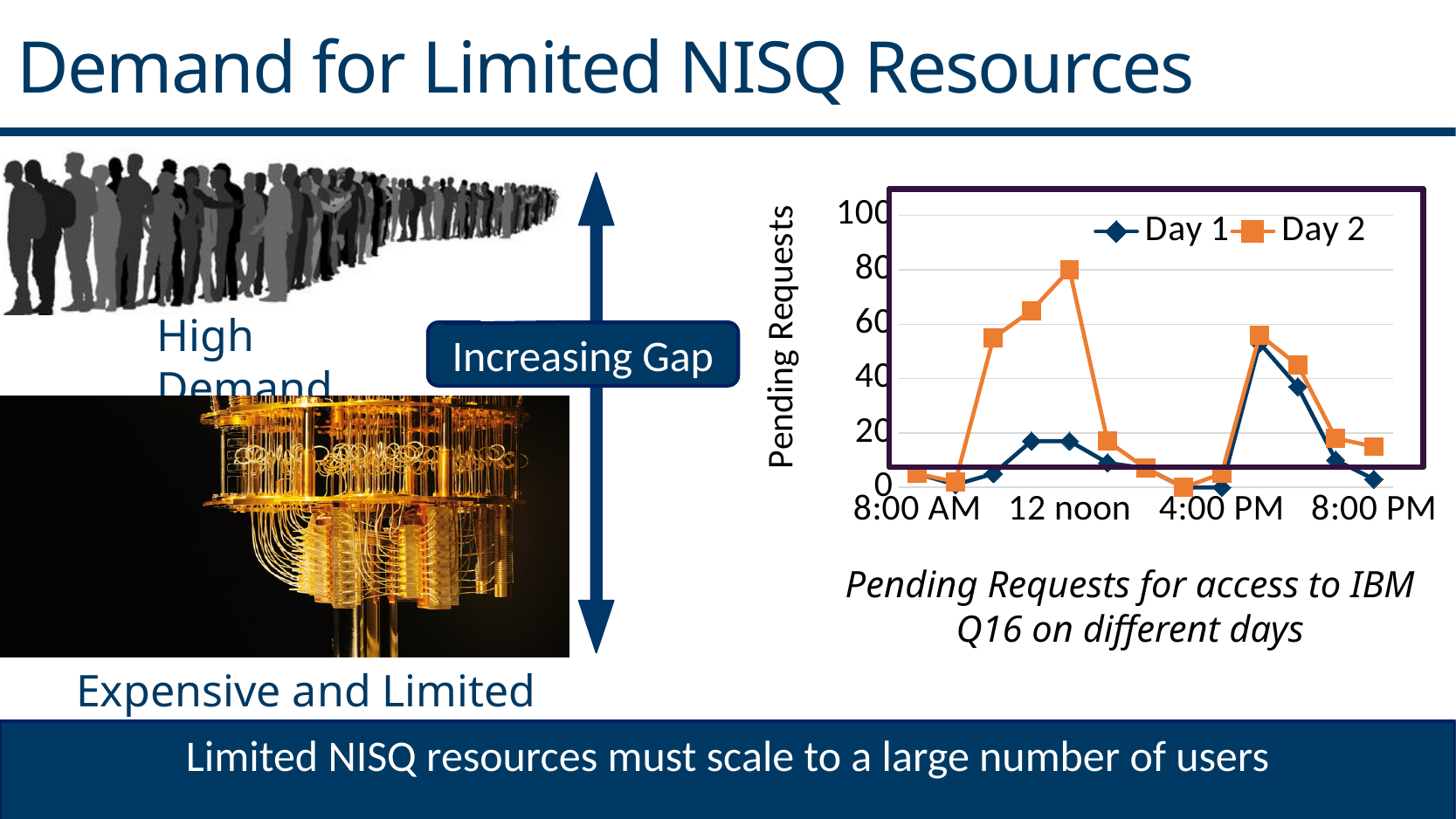
What is the label on the chart's vertical axis? Pending Requests Is the value for Day 1 at 12 noon greater or less than 20? less What kind of chart is shown on the slide? line chart Which series reaches the higher peak value, Day 1 or Day 2? Day 2 Is the value for Day 1 at 8:00 AM greater or less than 20? less How many time labels are shown on the chart's x axis? 4 What are the two series named in the chart's legend? Day 1 and Day 2 Is the value for Day 2 at 4:00 PM greater or less than 20? less How many series does the chart's legend list? 2